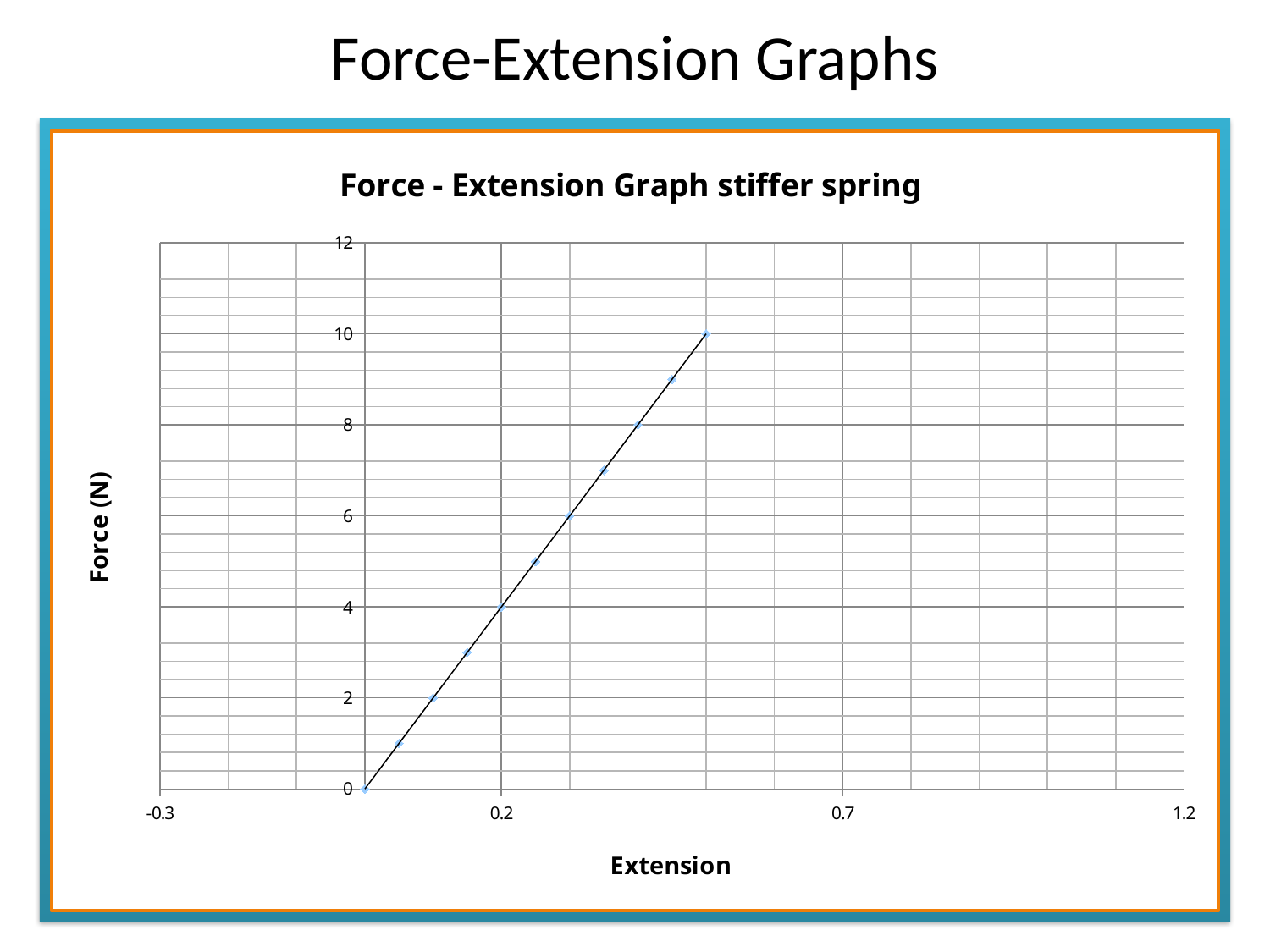
What is the highest force value plotted on the chart? 10 What is the difference between the highest and lowest force values plotted? 10 Is the extension at the highest plotted point greater or less than 0.2? greater What is the label of the vertical axis? Force (N) What is the maximum value shown on the Force (N) axis? 12 Does the force rise or fall as extension increases along the x axis? rise What is the lowest force value plotted on the chart? 0 What kind of chart is shown on the slide? line chart Is the extension at the highest plotted point greater or less than 0.7? less What is the title of the chart? Force - Extension Graph stiffer spring What is the force at an extension of 0.2? 4 How many data points are plotted on the chart? 11